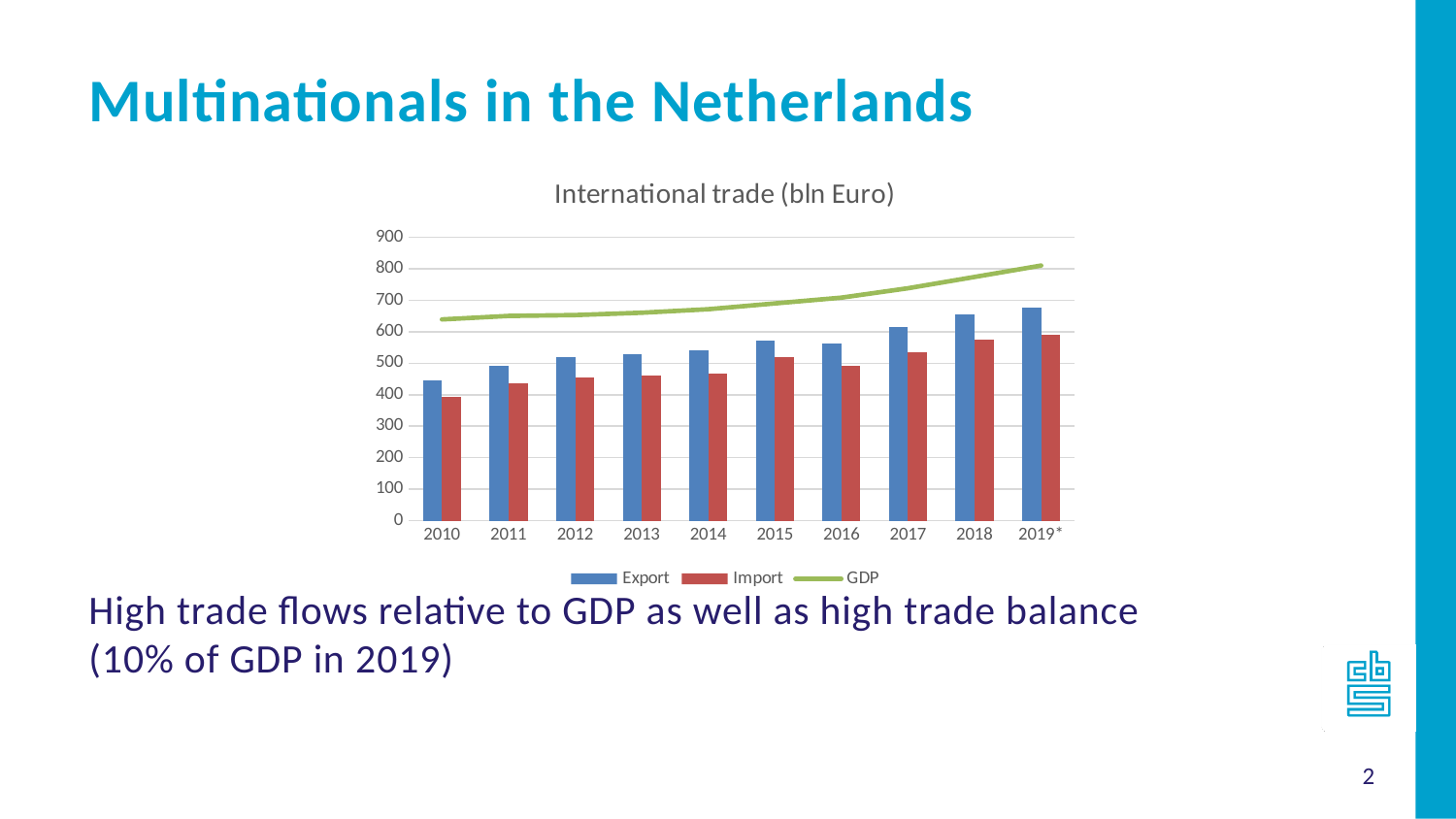
In which year is Import lowest? 2010 In which year is Export highest? 2019* Is the value for Export in 2018 greater or less than 600? greater How many years are shown on the x axis? 10 In 2015, which is larger, Export or Import? Export What kind of chart is this? Combined bar and line chart Which series is drawn as a line rather than bars? GDP What is the title of the chart? International trade (bln Euro) Is the value for Export in 2010 greater or less than 500? less Does GDP rise or fall from 2010 to 2019*? rise How many series does the legend list? 3 Is the value for Import in 2019* greater or less than 500? greater